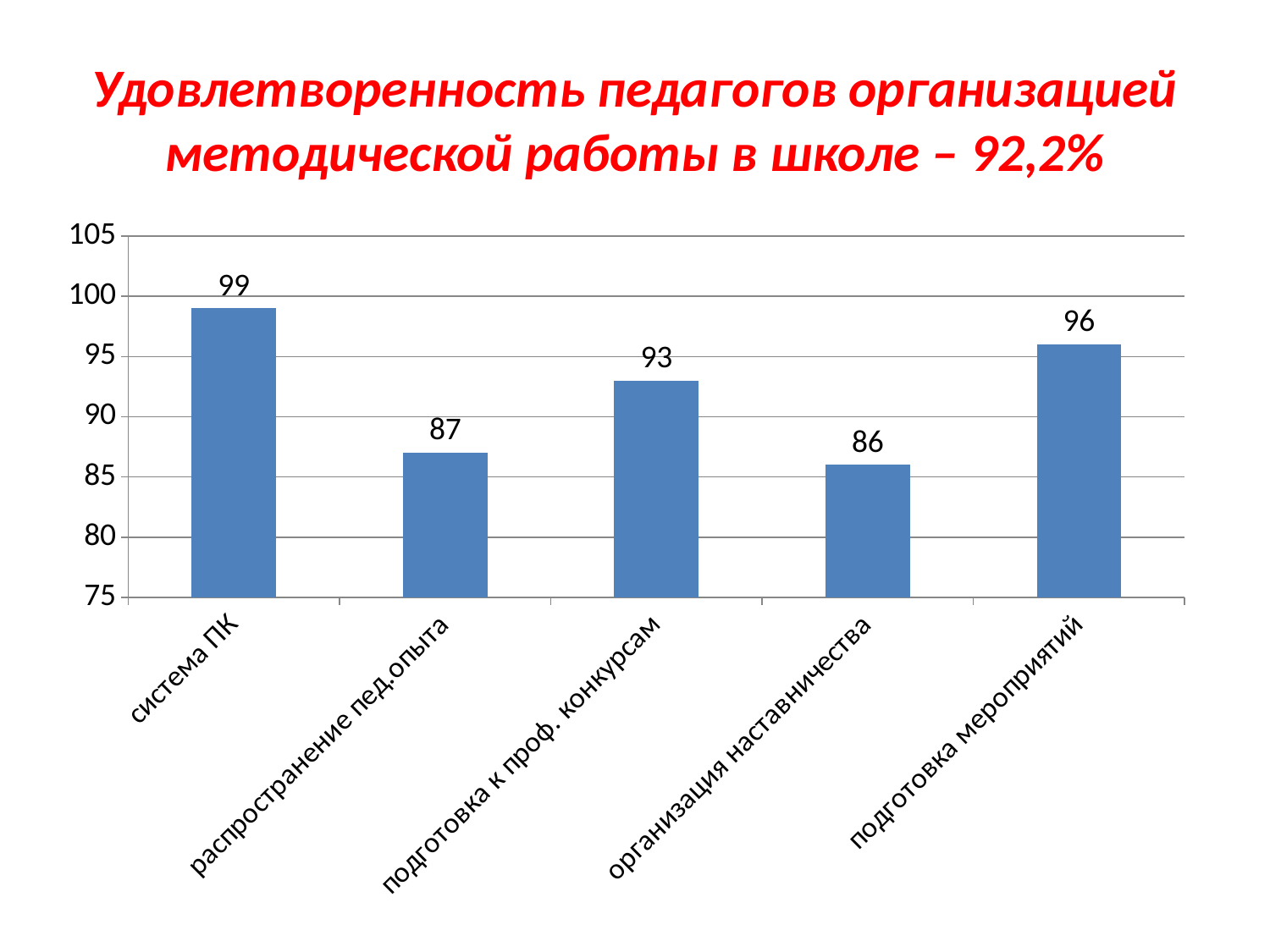
What is the value for система ПК? 99 What is the value for подготовка мероприятий? 96 What is the difference between the values for система ПК and организация наставничества? 13 What is the title of the slide? Удовлетворенность педагогов организацией методической работы в школе – 92,2% Which category has the lowest value? организация наставничества How many categories are shown in the chart? 5 What is the value for распространение пед.опыта? 87 Which category has the highest value? система ПК What is the value for организация наставничества? 86 Which is larger, the value for подготовка мероприятий or the value for подготовка к проф. конкурсам? подготовка мероприятий What kind of chart is shown on the slide? bar chart What is the value for подготовка к проф. конкурсам? 93